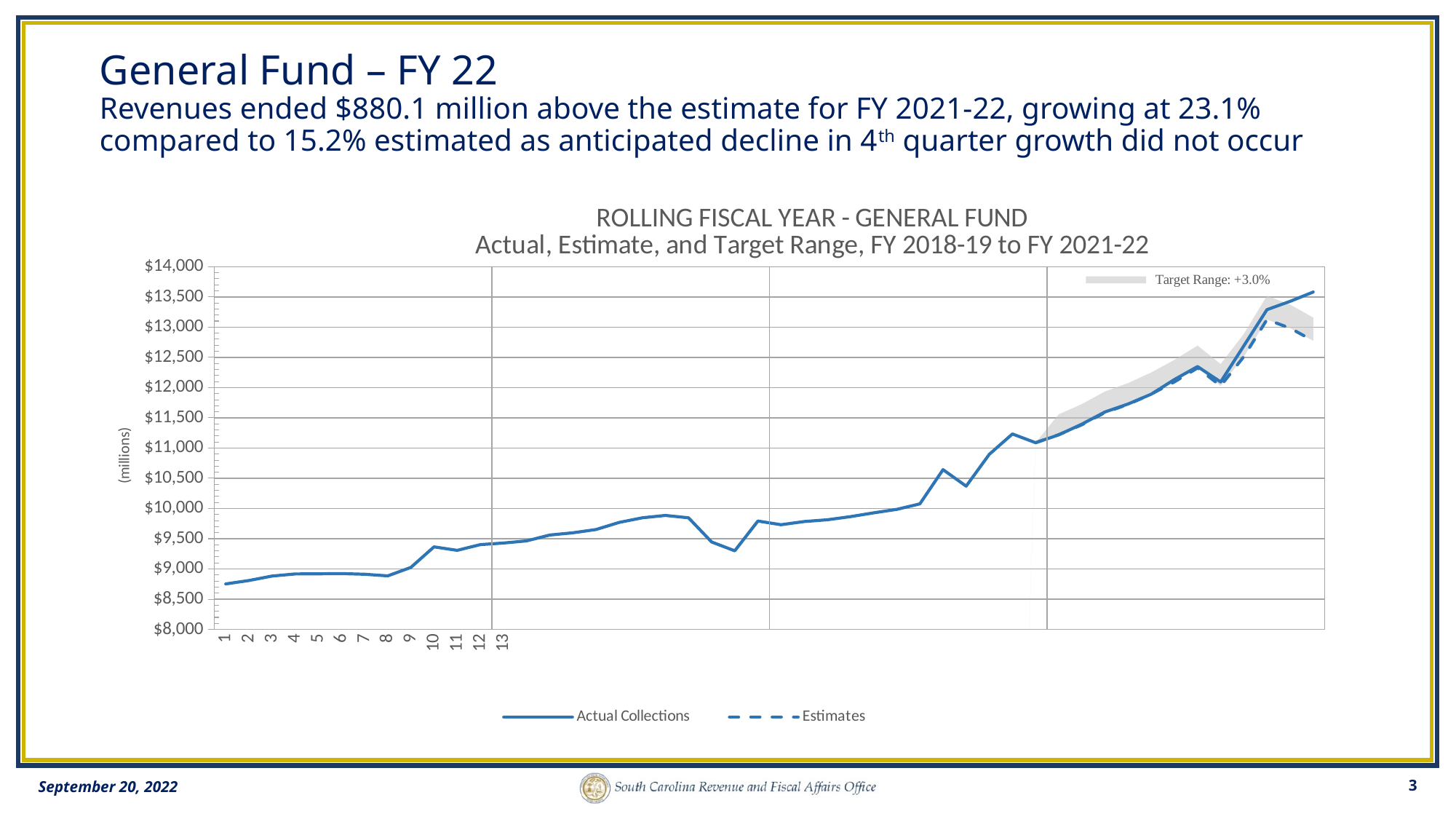
Do the Actual Collections values generally rise or fall along the x axis? rise How many series does the chart legend list? 2 At the right end of the chart, which series is higher: Actual Collections or Estimates? Actual Collections Is the Actual Collections value at point 10 greater or less than $9,000? greater What are the two series named in the chart legend? Actual Collections and Estimates Is the final Estimates value at the right end of the chart greater or less than $13,000? less Which point on the Actual Collections line has the lowest value? 1 What is the title of the chart? ROLLING FISCAL YEAR - GENERAL FUND Actual, Estimate, and Target Range, FY 2018-19 to FY 2021-22 What kind of chart is shown on the slide? line chart Is the Actual Collections value at point 1 greater or less than $9,000? less